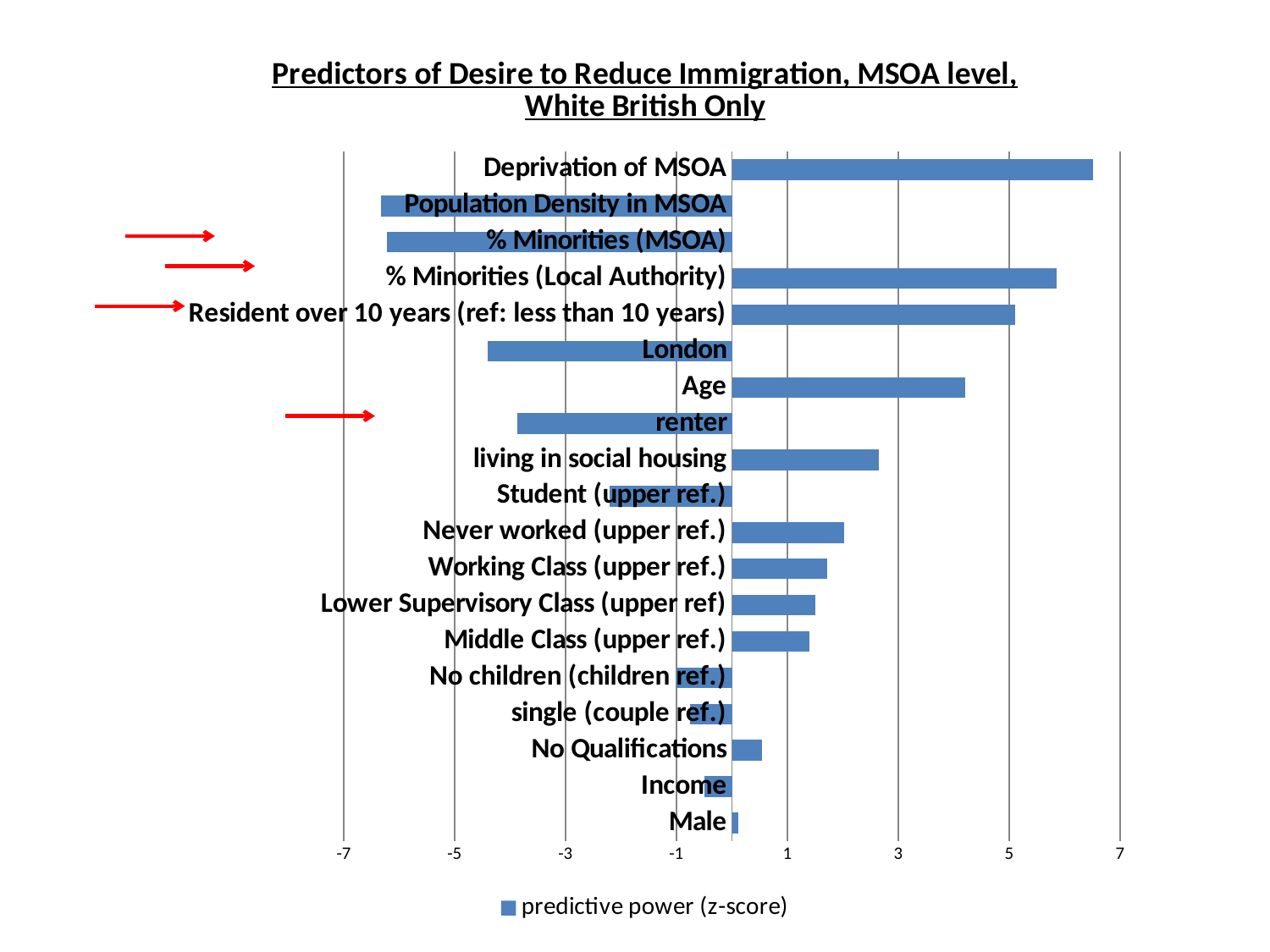
Is the value for Deprivation of MSOA greater or less than 5? greater Which predictor has the highest predictive power (z-score)? Deprivation of MSOA What series name is shown in the chart legend? predictive power (z-score) Is the value for London greater or less than -3? less How many series does the legend list? 1 Which has the larger value, Age or living in social housing? Age What kind of chart is shown on the slide? bar chart Is the value for Population Density in MSOA greater or less than -5? less Which has the larger value, Resident over 10 years (ref: less than 10 years) or Age? Resident over 10 years (ref: less than 10 years) How many categories (predictors) are plotted in the chart? 19